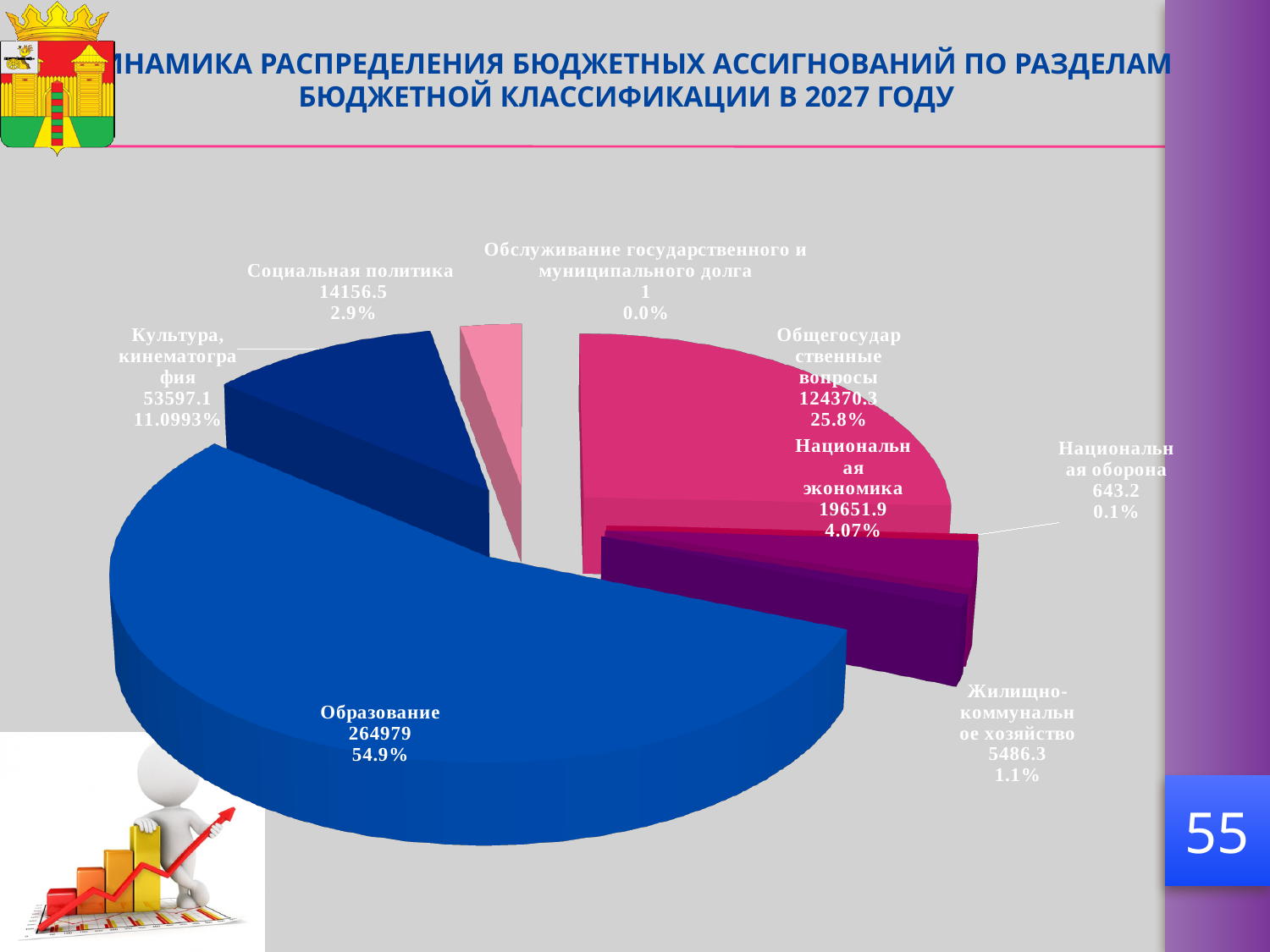
What is the value shown for Жилищно-коммунальное хозяйство? 5486.3 What kind of chart is shown on the slide? Pie chart Which category has the smallest value in the pie chart? Обслуживание государственного и муниципального долга What is the difference between the values for Социальная политика and Жилищно-коммунальное хозяйство? 8670.2 What share of the pie does Образование represent? 54.9% What is the value shown for Образование? 264979 Which is larger: the value for Национальная экономика or the value for Национальная оборона? Национальная экономика How many categories (slices) does the pie chart show? 8 What is the value shown for Социальная политика? 14156.5 Which category has the largest share of the pie? Образование What share of the pie does Общегосударственные вопросы represent? 25.8% What share of the pie does Культура, кинематография represent? 11.0993%